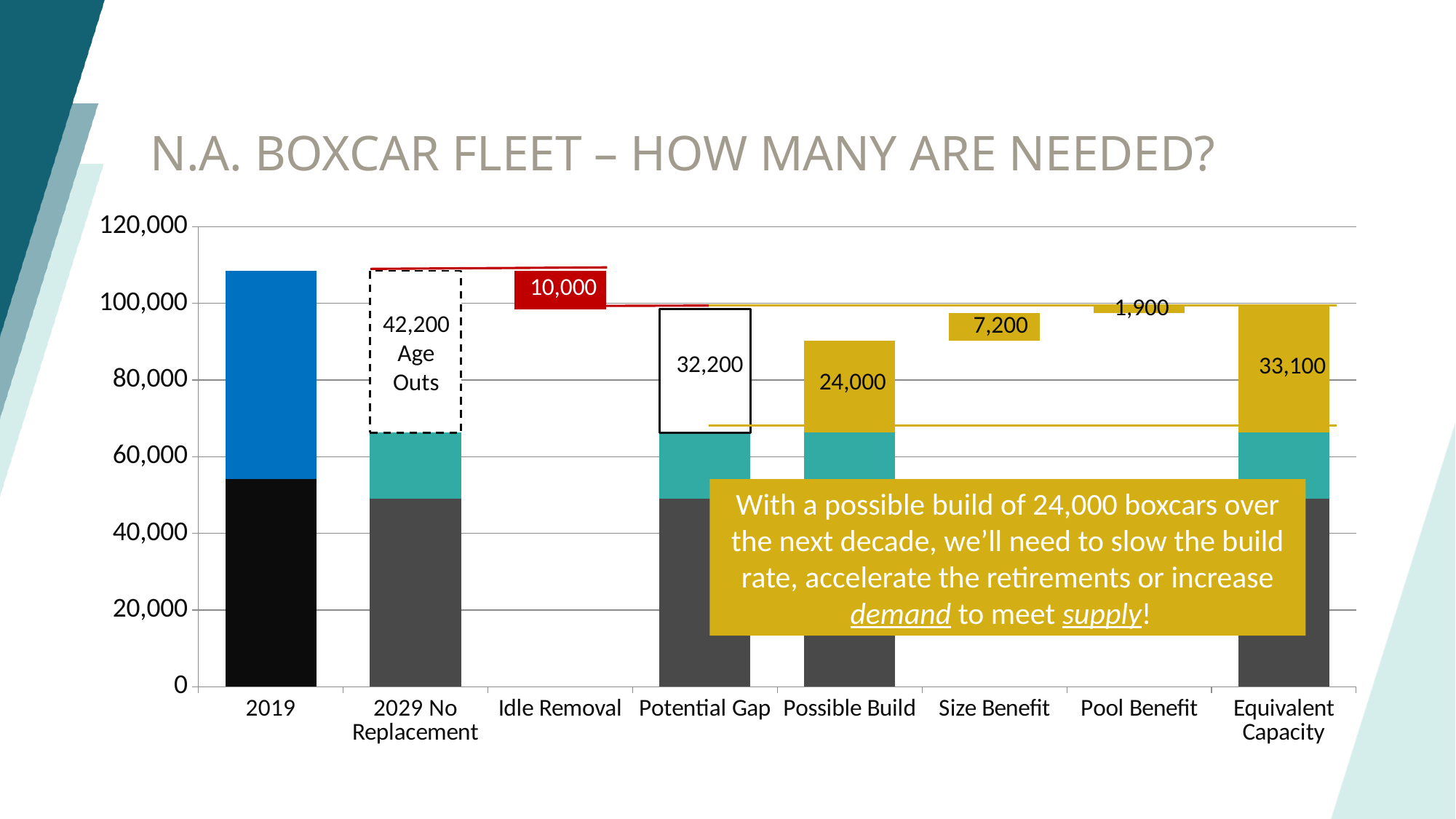
Is the total height of the 2019 bar greater or less than 100,000? greater Which is larger, the Size Benefit value or the Pool Benefit value? Size Benefit What value is labelled on the Pool Benefit bar? 1,900 What value is labelled on the Possible Build segment? 24,000 What value is labelled on the Idle Removal bar? 10,000 What value is labelled on the Equivalent Capacity segment? 33,100 What is the title of the chart on the slide? N.A. BOXCAR FLEET – HOW MANY ARE NEEDED? What value is labelled in the Potential Gap box? 32,200 How many categories are shown along the x axis of the chart? 8 What is the difference between the Possible Build value (24,000) and the Size Benefit value (7,200)? 16,800 What kind of chart is shown on the slide? bar chart What value is labelled on the Size Benefit bar? 7,200